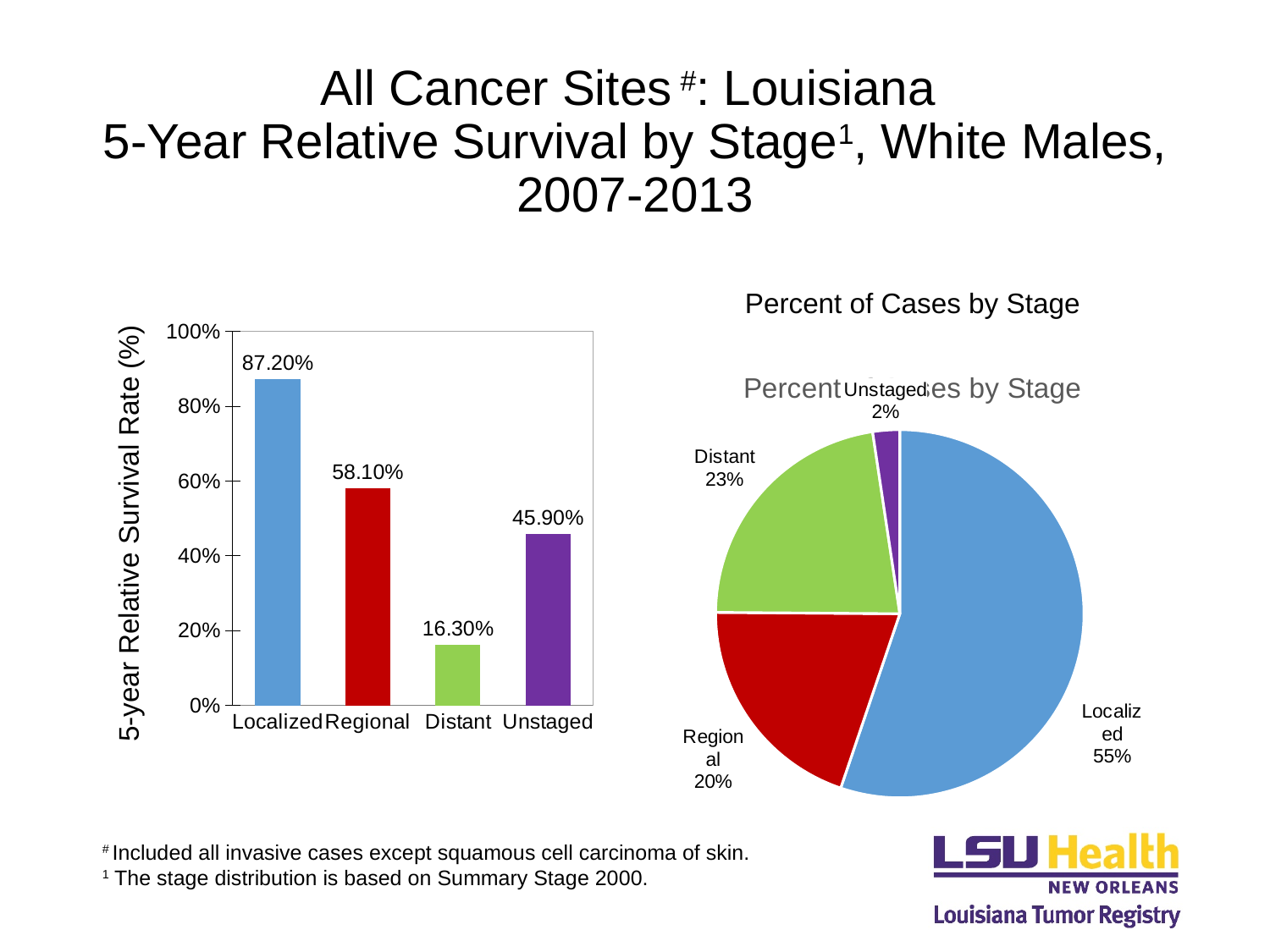
In the pie chart 'Percent of Cases by Stage', what share of cases is Distant? 23% In the bar chart on the left, what is the 5-year relative survival rate for Localized stage? 87.20% In the pie chart 'Percent of Cases by Stage', which stage has the smallest share of cases? Unstaged In the bar chart on the left, how many stage categories are shown? 4 In the bar chart on the left, which stage has the highest 5-year relative survival rate? Localized In the bar chart on the left, which stage has the lowest 5-year relative survival rate? Distant In the bar chart on the left, what is the 5-year relative survival rate for Unstaged? 45.90% What kind of chart is the chart on the left of the slide? Bar chart In the bar chart on the left, what is the 5-year relative survival rate for Distant stage? 16.30% In the bar chart on the left, what is the difference between the survival rates for Localized and Regional? 29.10% In the bar chart on the left, which has a higher survival rate, Regional or Unstaged? Regional In the pie chart 'Percent of Cases by Stage', what share of cases is Localized? 55%